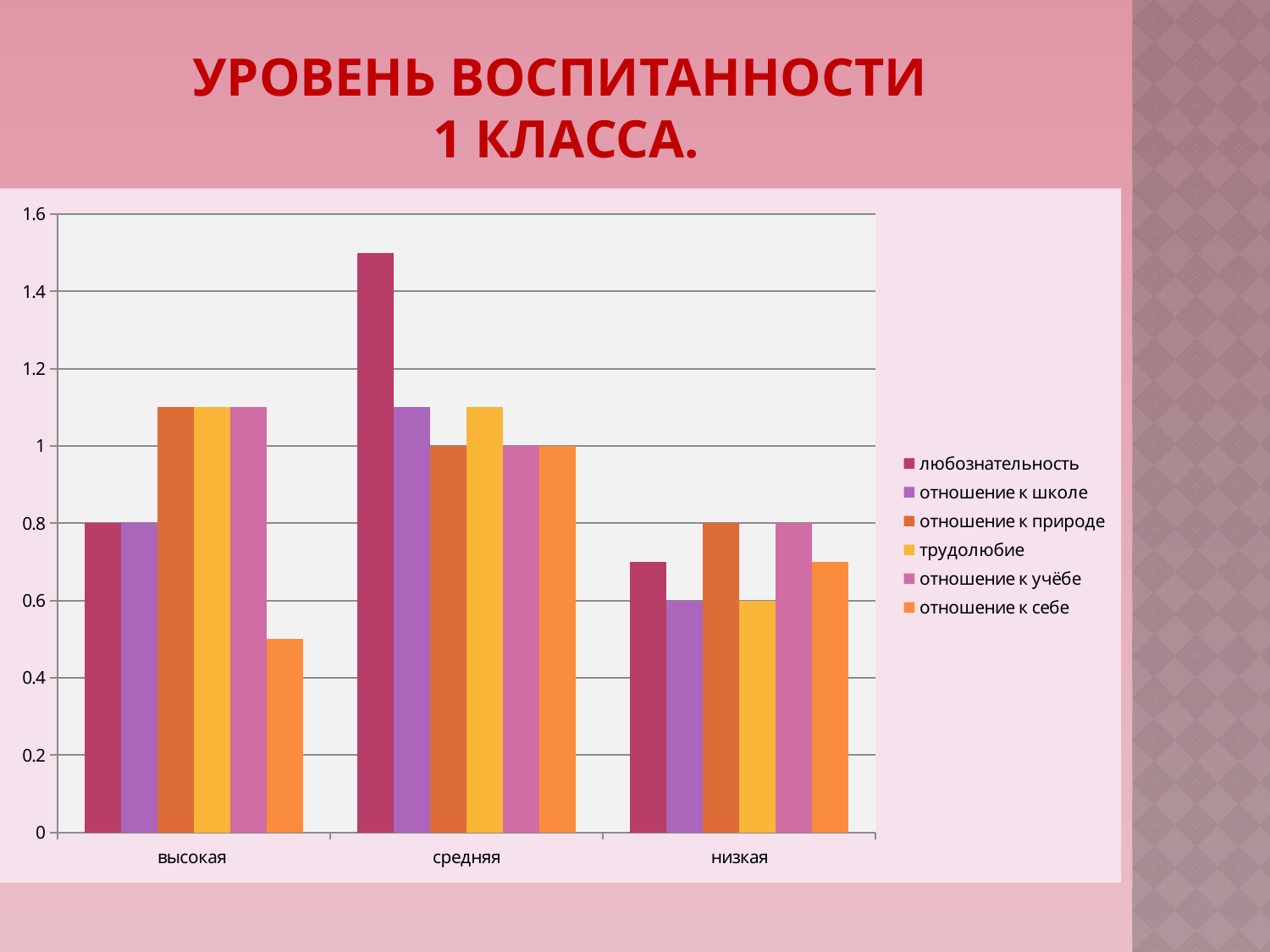
In which category is любознательность highest? средняя Is the value of отношение к себе for высокая greater or less than 0.6? less What is the value of отношение к природе for the category низкая? 0.8 Is the value of любознательность for средняя greater or less than 1.4? greater What is the value of отношение к природе for the category средняя? 1 Which is larger: любознательность for высокая or любознательность for средняя? средняя How many categories are shown on the x axis? 3 What kind of chart is shown on the slide? bar chart What is the title of the slide containing the chart? УРОВЕНЬ ВОСПИТАННОСТИ 1 КЛАССА. What is the value of отношение к школе for the category низкая? 0.6 What is the value of любознательность for the category высокая? 0.8 How many series does the legend list? 6